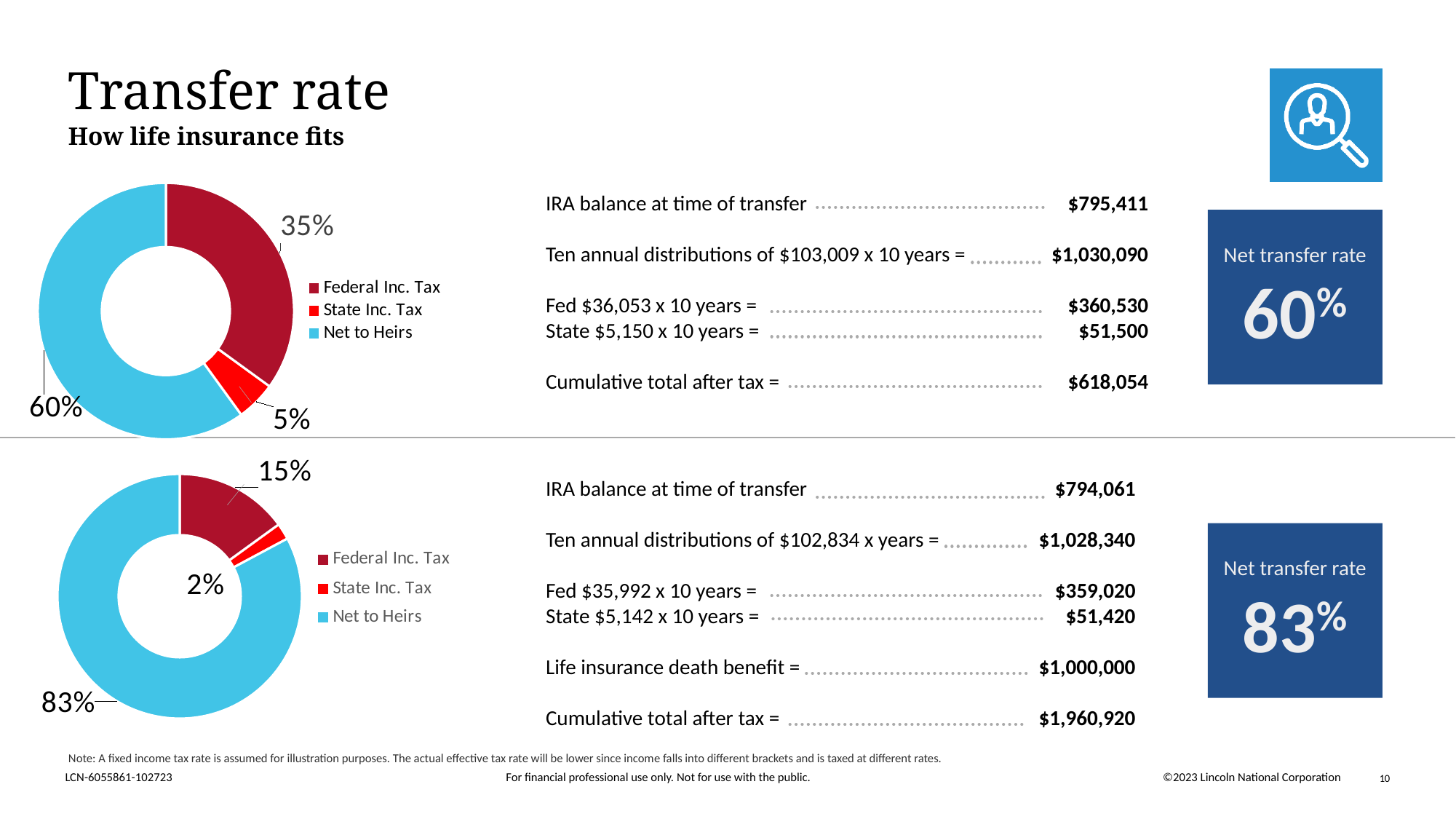
In the top donut chart, what share is Federal Inc. Tax? 35% In the top donut chart, which category has the largest share? Net to Heirs What type of chart is used at the top left of the slide? Donut (pie) chart In the bottom donut chart, which category has the smallest share? State Inc. Tax In the bottom donut chart, what share is Federal Inc. Tax? 15% In the top donut chart, what share goes to Net to Heirs? 60% How many categories does the legend of the bottom donut chart list? 3 In the bottom donut chart, what share goes to Net to Heirs? 83% In the top donut chart, what colour represents Net to Heirs? Light blue In the top donut chart, what share is State Inc. Tax? 5% In the top donut chart, what is the difference between the Federal Inc. Tax share and the State Inc. Tax share? 30% Which is larger: the Net to Heirs share in the top chart or in the bottom chart? Bottom chart